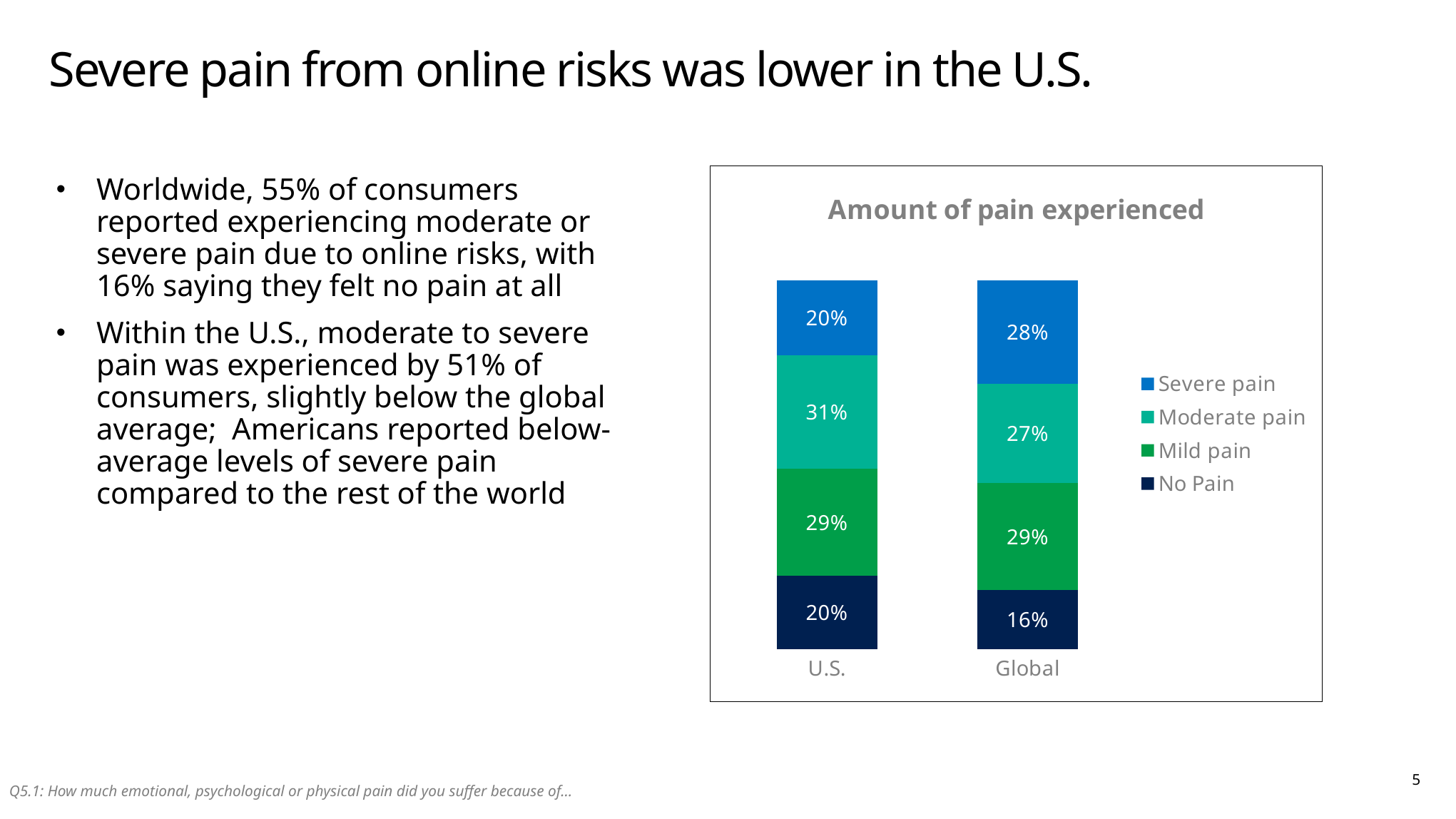
What is the value for Mild pain in the U.S.? 29% What is the difference between the Severe pain values for Global and the U.S.? 8% How many categories are shown on the x axis? 2 Which is larger, Moderate pain in the U.S. or Moderate pain for Global? U.S. What is the title of the chart? Amount of pain experienced Which segment is the largest in the U.S. bar? Moderate pain What is the value for No Pain for Global? 16% What kind of chart is shown? Stacked bar chart Which segment is the smallest in the Global bar? No Pain How many series does the legend list? 4 What is the value for Moderate pain for Global? 27% What is the value for Severe pain in the U.S.? 20%